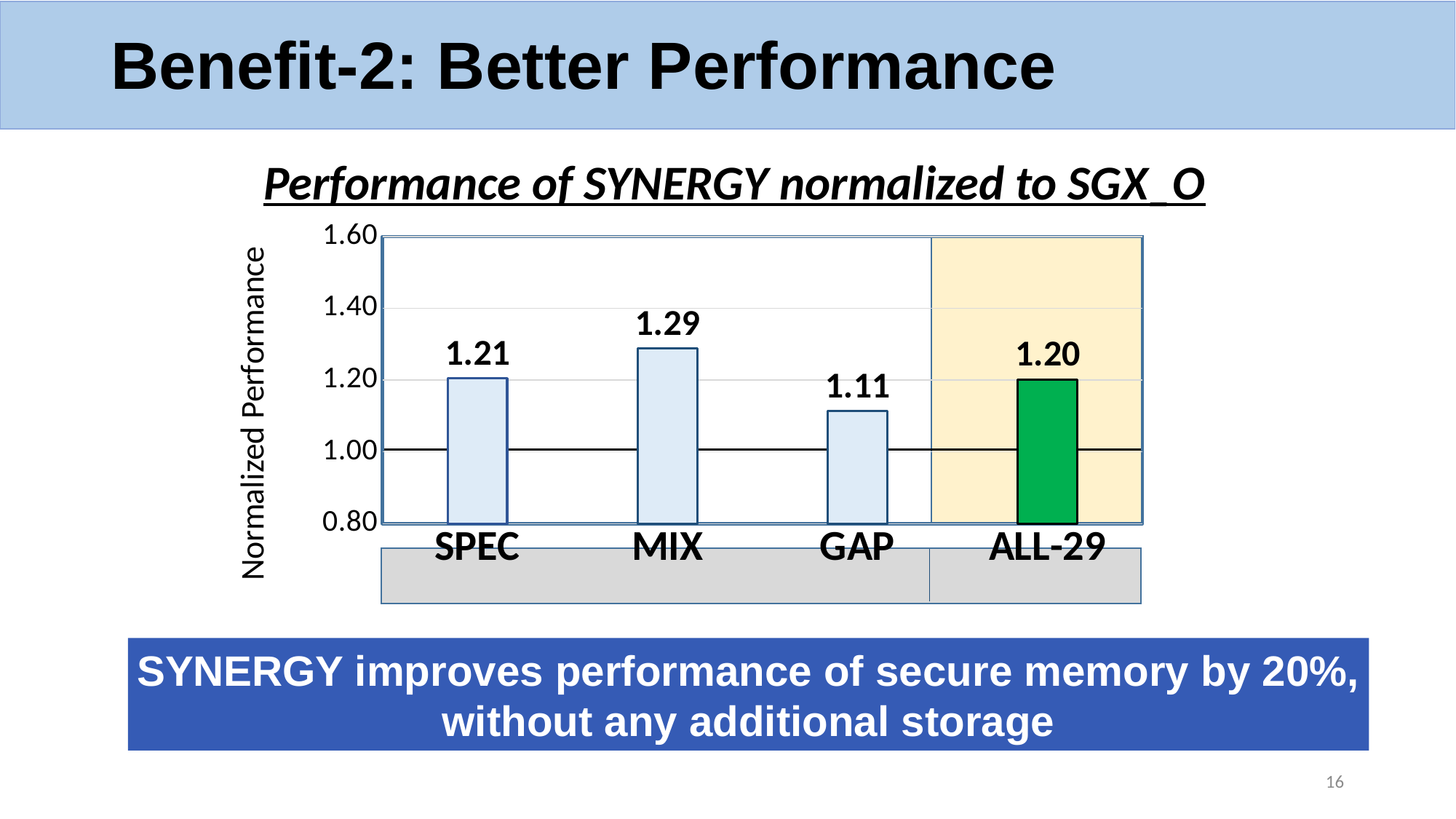
What is the normalized performance value for MIX? 1.29 What kind of chart is shown on the slide? bar chart Which category has the highest normalized performance? MIX What is the normalized performance value for GAP? 1.11 How many categories are shown on the x axis of the chart? 4 What is the title of the chart? Performance of SYNERGY normalized to SGX_O Which has a higher normalized performance, SPEC or GAP? SPEC Is the value for GAP greater or less than 1.20? less What is the normalized performance value for SPEC? 1.21 What is the difference between the normalized performance of MIX and GAP? 0.18 What is the normalized performance value for ALL-29? 1.20 Which category has the lowest normalized performance? GAP